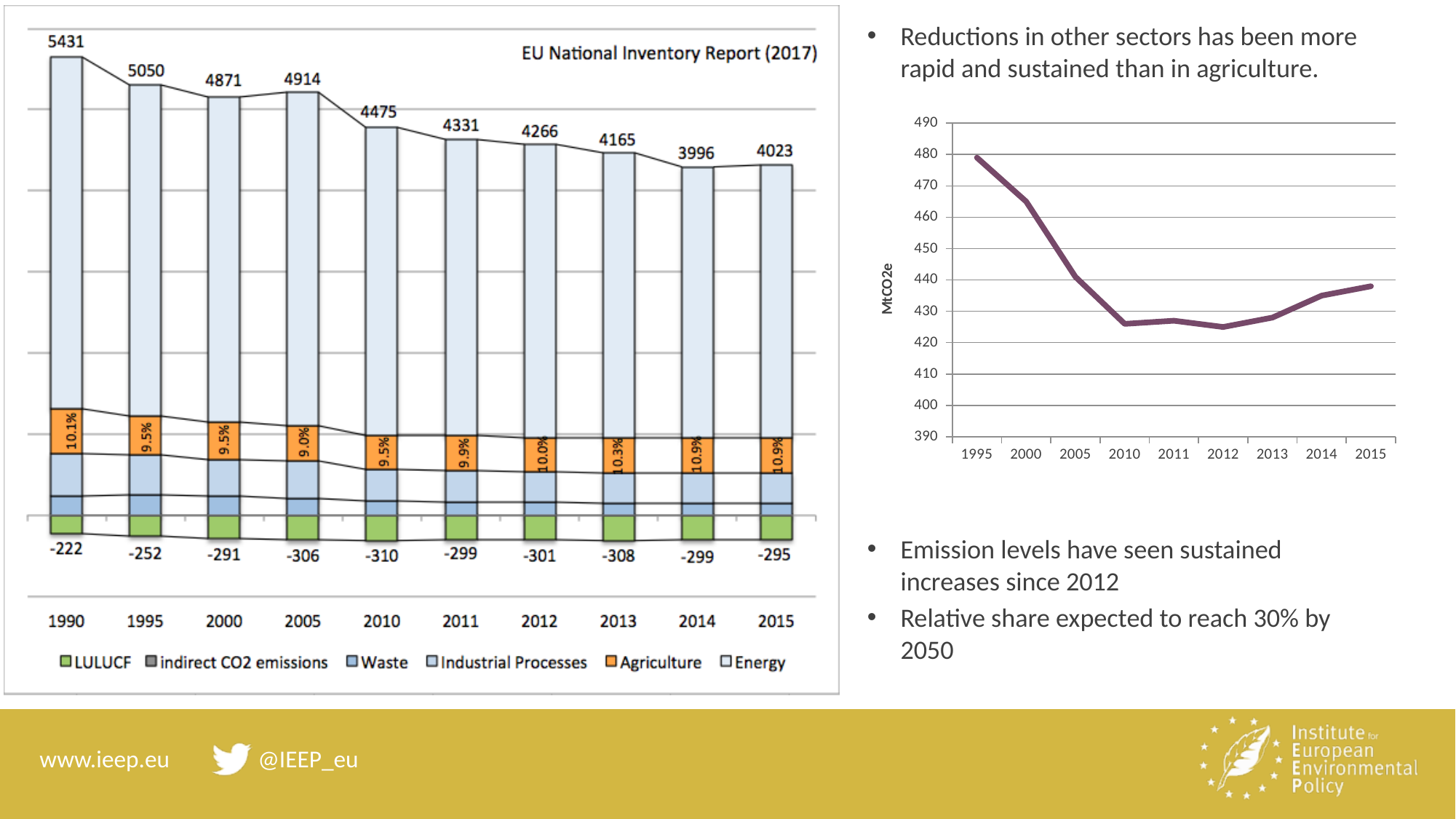
In the EU National Inventory Report (2017) chart, what is the total value labelled for 1990? 5431 In the EU National Inventory Report (2017) chart, how many years are shown on the x axis? 10 In the line chart on the right, is the value for 1995 greater or less than 470? greater In the EU National Inventory Report (2017) chart, what is the LULUCF value labelled below the 2010 bar? -310 In the EU National Inventory Report (2017) chart, how many series does the legend list? 6 In the EU National Inventory Report (2017) chart, which year has the lowest total value? 2014 In the EU National Inventory Report (2017) chart, what percentage is shown for Agriculture in 2013? 10.3% In the EU National Inventory Report (2017) chart, what is the difference between the total values for 1990 and 2015? 1408 In the EU National Inventory Report (2017) chart, what is the total value labelled for 2014? 3996 In the EU National Inventory Report (2017) chart, which year has the highest total value? 1990 What kind of chart is the chart on the right of the slide with the MtCO2e axis? line chart In the line chart on the right, is the value for 2012 greater or less than 430? less